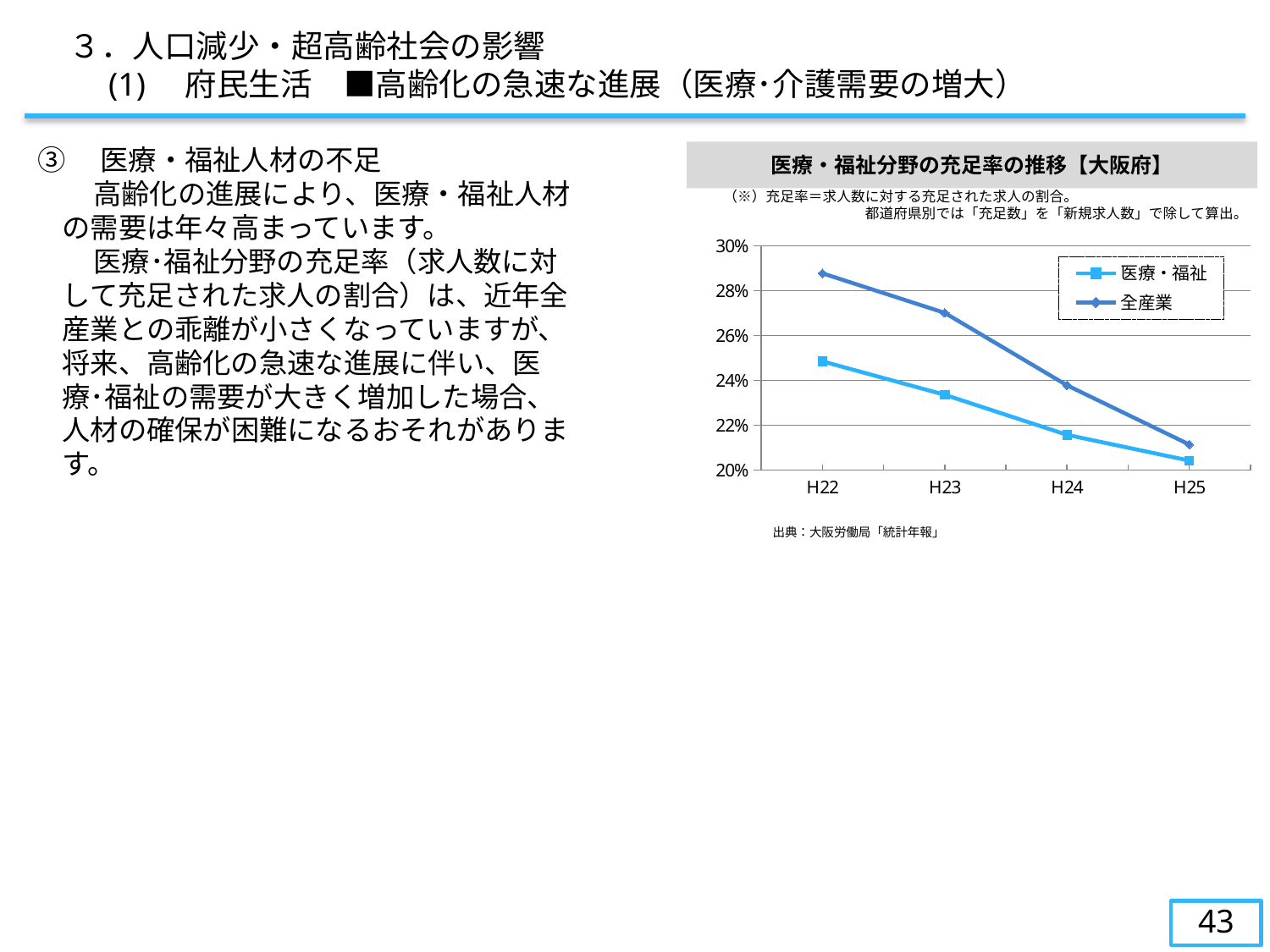
Do the values for 医療・福祉 rise or fall from H22 to H25? fall In H22, which series has the higher value, 医療・福祉 or 全産業? 全産業 Is the value for 医療・福祉 in H24 greater or less than 22%? less Is the value for 全産業 in H25 greater or less than 22%? less How many series does the legend of the chart list? 2 In which year is the value for 全産業 highest? H22 Do the values for 全産業 rise or fall from H22 to H25? fall How many years are plotted along the x axis of the chart? 4 What kind of chart is shown on the slide? line chart Is the value for 全産業 in H22 greater or less than 28%? greater In which year is the value for 医療・福祉 lowest? H25